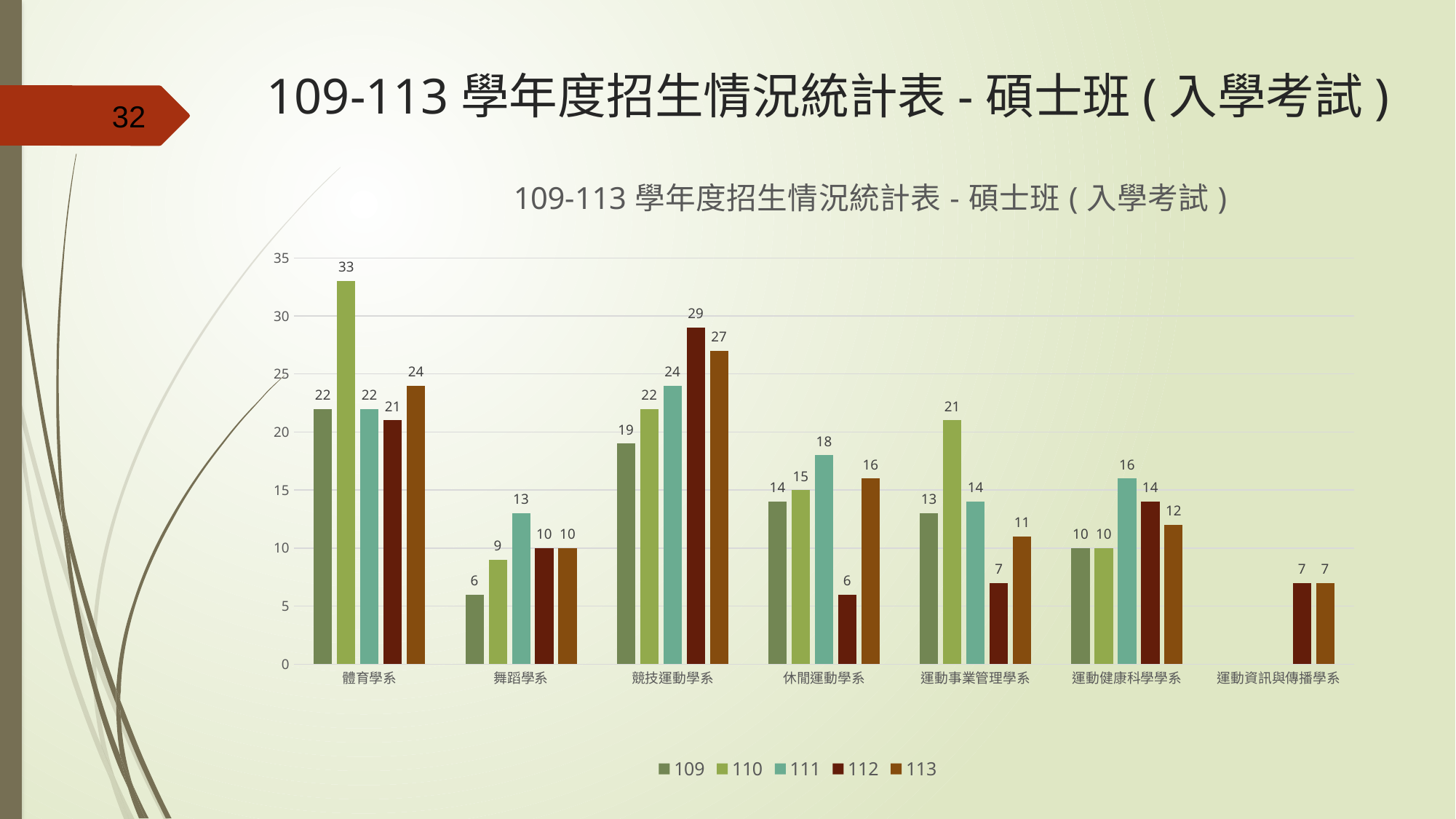
Which category has the lowest value in series 109? 舞蹈學系 Do the values for 舞蹈學系 rise or fall from series 109 to series 111? rise How many categories (departments) are shown on the x axis? 7 What is the title of the chart? 109-113 學年度招生情況統計表 - 碩士班 ( 入學考試 ) How many series does the legend list? 5 What is the value for 體育學系 in series 110? 33 Which category has the highest value in series 110? 體育學系 What is the difference between the 112 and 113 values for 運動事業管理學系? 4 Which is larger for 運動健康科學學系: the value for 111 or the value for 113? 111 What is the value for 休閒運動學系 in series 111? 18 What is the value for 競技運動學系 in series 112? 29 What kind of chart is shown on the slide? bar chart